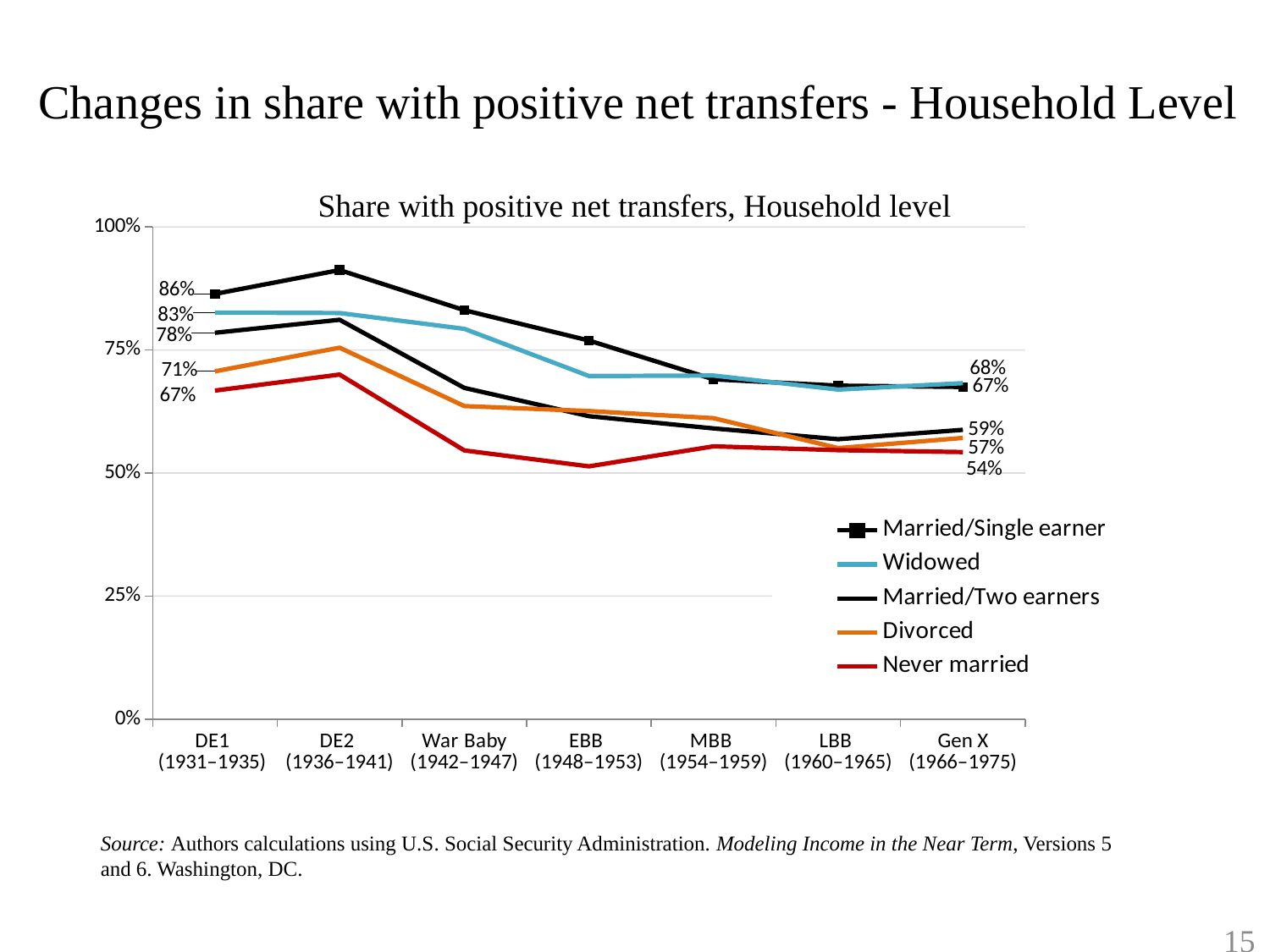
What is the difference between the Married/Single earner and Never married values at DE1 (1931–1935)? 19 percentage points How many series does the legend list? 5 By how much does the Never married value fall from DE1 (1931–1935) to Gen X (1966–1975)? 13 percentage points Which series has the highest value at DE1 (1931–1935)? Married/Single earner What kind of chart is shown on the slide? Line chart What is the value for Never married at Gen X (1966–1975)? 54% Which series has the lowest value at Gen X (1966–1975)? Never married At DE1 (1931–1935), which is larger: Widowed or Divorced? Widowed What is the value for Widowed at DE1 (1931–1935)? 83% What is the value for Married/Single earner at DE1 (1931–1935)? 86% What is the value for Married/Two earners at Gen X (1966–1975)? 59% Is the value for Married/Single earner at DE2 (1936–1941) greater or less than 75%? greater